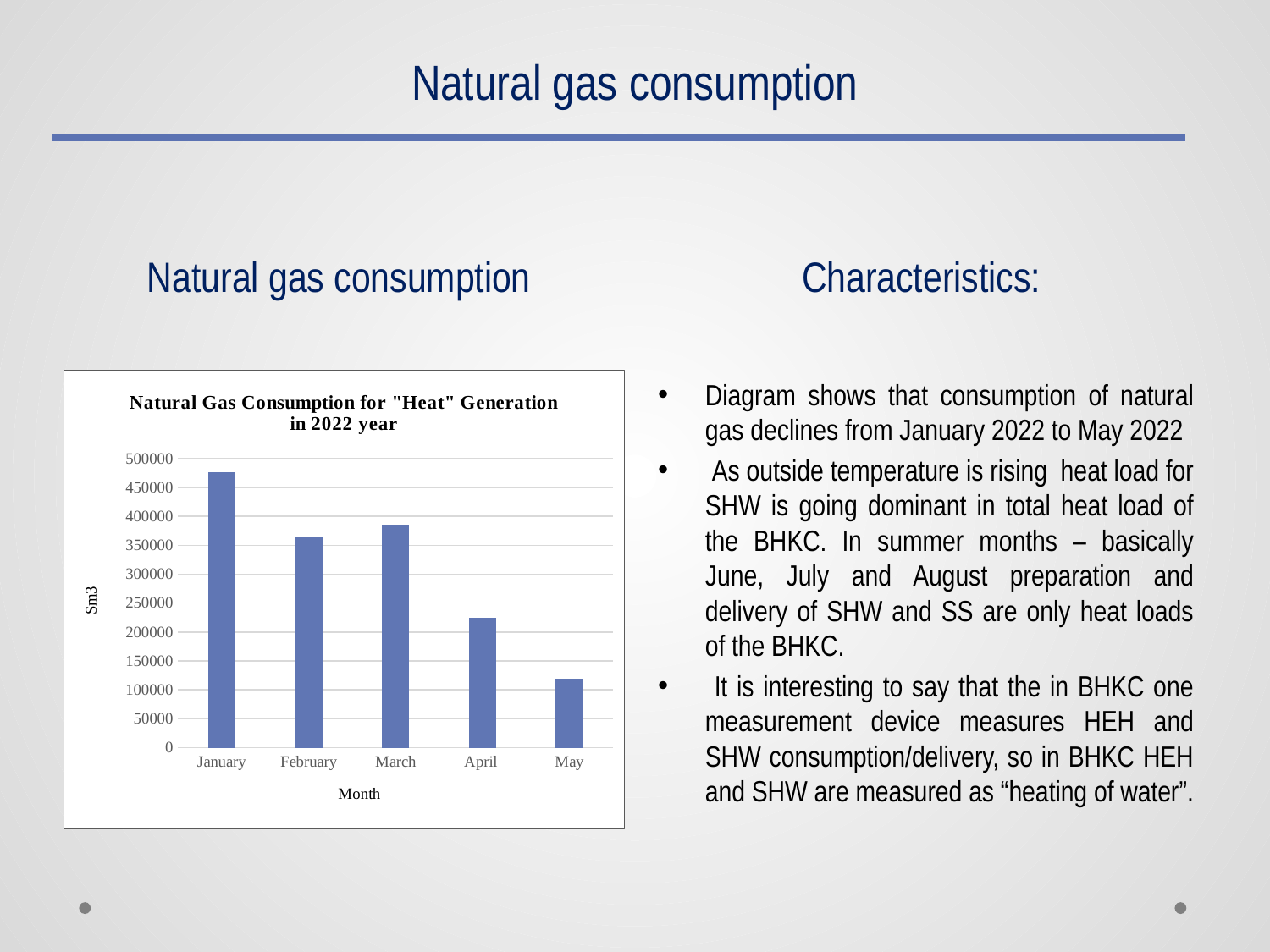
Overall, do the values rise or fall from January to May? fall Which month has the lowest natural gas consumption in the chart? May Is the value for January greater or less than 450000? greater What is the label on the y axis of the chart? Sm3 Which month has the larger value, January or May? January What kind of chart is shown on the slide? bar chart Is the value for April greater or less than 250000? less How many months are shown on the x axis of the chart? 5 What is the title of the chart? Natural Gas Consumption for "Heat" Generation in 2022 year Which month has the highest natural gas consumption in the chart? January Which month has the larger value, March or April? March Is the value for May greater or less than 150000? less